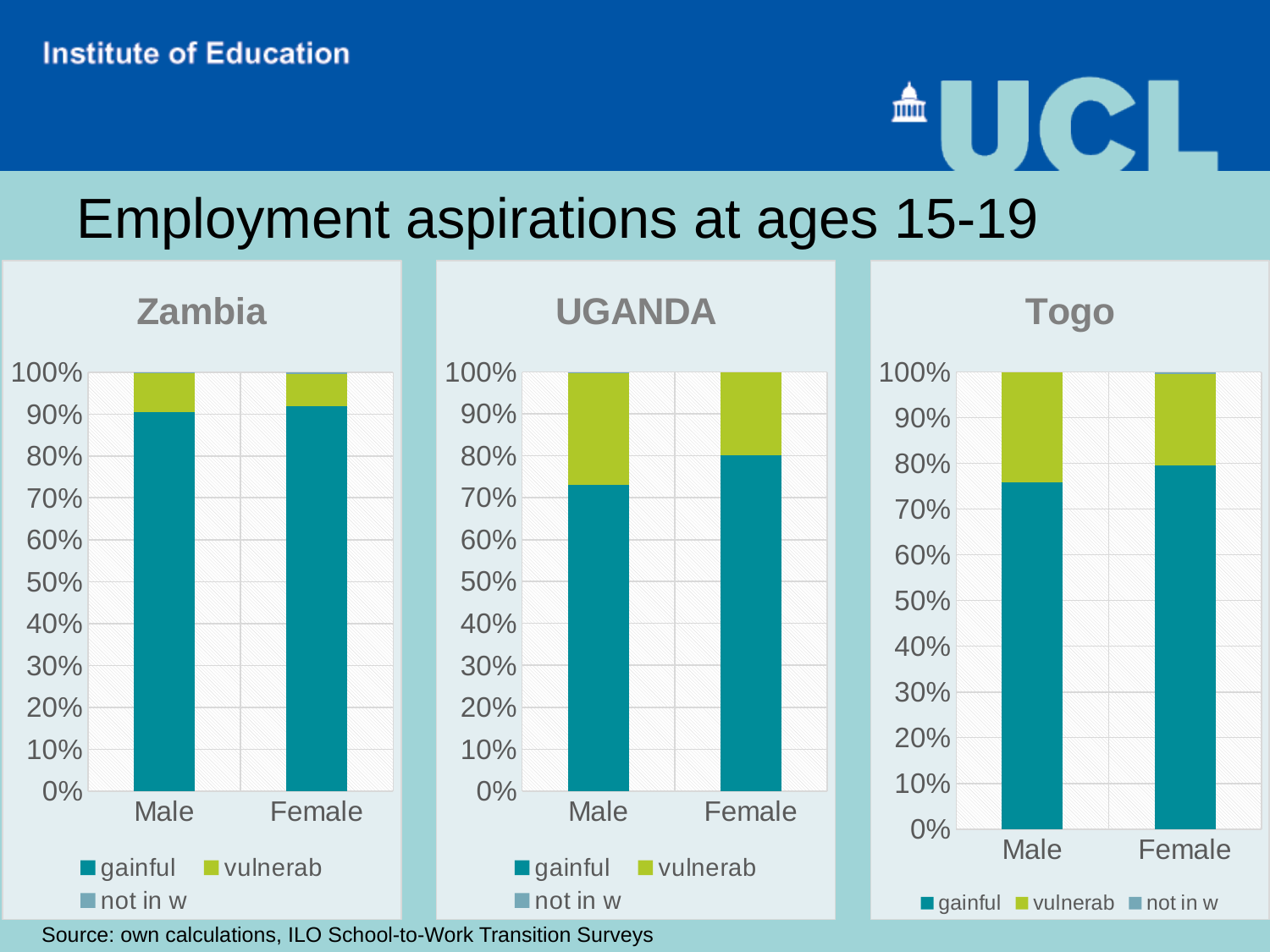
What kind of chart is the Zambia chart? stacked bar chart In the Togo chart, is the gainful value for Male greater or less than 70%? greater What is the title of the chart on the right of the slide? Togo Which is larger: the vulnerable segment for Male in the UGANDA chart or the vulnerable segment for Male in the Zambia chart? UGANDA In the UGANDA chart, is the gainful value for Female greater or less than 70%? greater How many series does the legend of the Togo chart list? 3 Which is larger: the gainful value for Male in the Zambia chart or the gainful value for Male in the UGANDA chart? Zambia In the UGANDA chart, is the gainful value for Male greater or less than 80%? less How many categories are shown on the x axis of the UGANDA chart? 2 In the UGANDA chart, which has the larger gainful value, Male or Female? Female